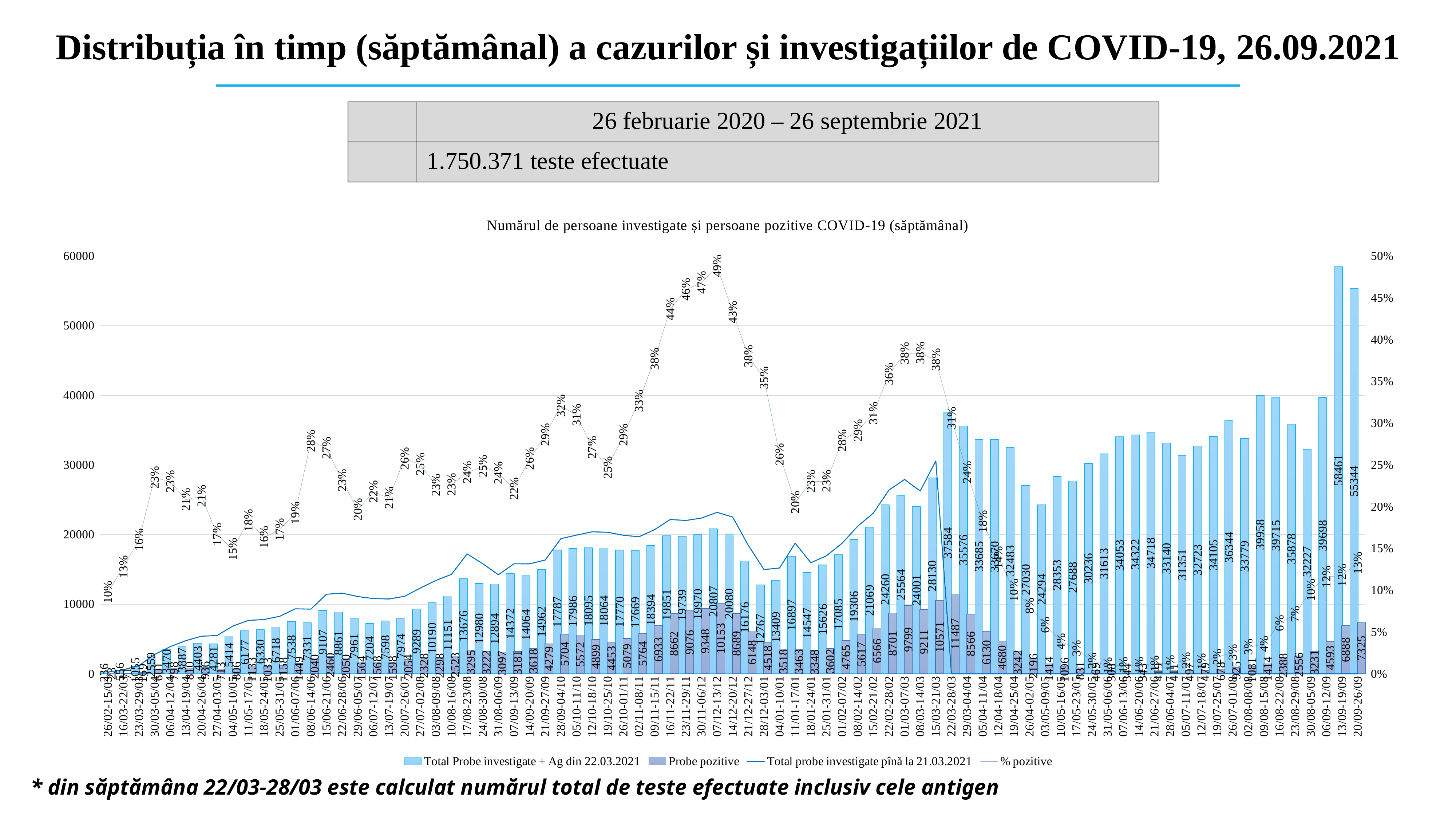
What is the value of Probe pozitive for the week 20/09-26/09? 7325 How many series does the chart legend list? 4 Which week has the highest % pozitive value? 07/12-13/12 Is the Total Probe investigate + Ag value for 13/09-19/09 greater or less than 50000? greater What is the difference between the Total Probe investigate + Ag values for 13/09-19/09 and 20/09-26/09? 3117 Which week has the highest Total Probe investigate + Ag bar? 13/09-19/09 What is the value of Total Probe investigate + Ag for the week 13/09-19/09? 58461 What is the title of the chart? Numărul de persoane investigate și persoane pozitive COVID-19 (săptămânal) What is the % pozitive value for the week 07/12-13/12? 49% What is the Probe pozitive value for the week 22/03-28/03? 11487 Which is larger: Probe pozitive for 13/09-19/09 or for 20/09-26/09? 20/09-26/09 What kind of chart is shown on the slide? Combined bar and line chart